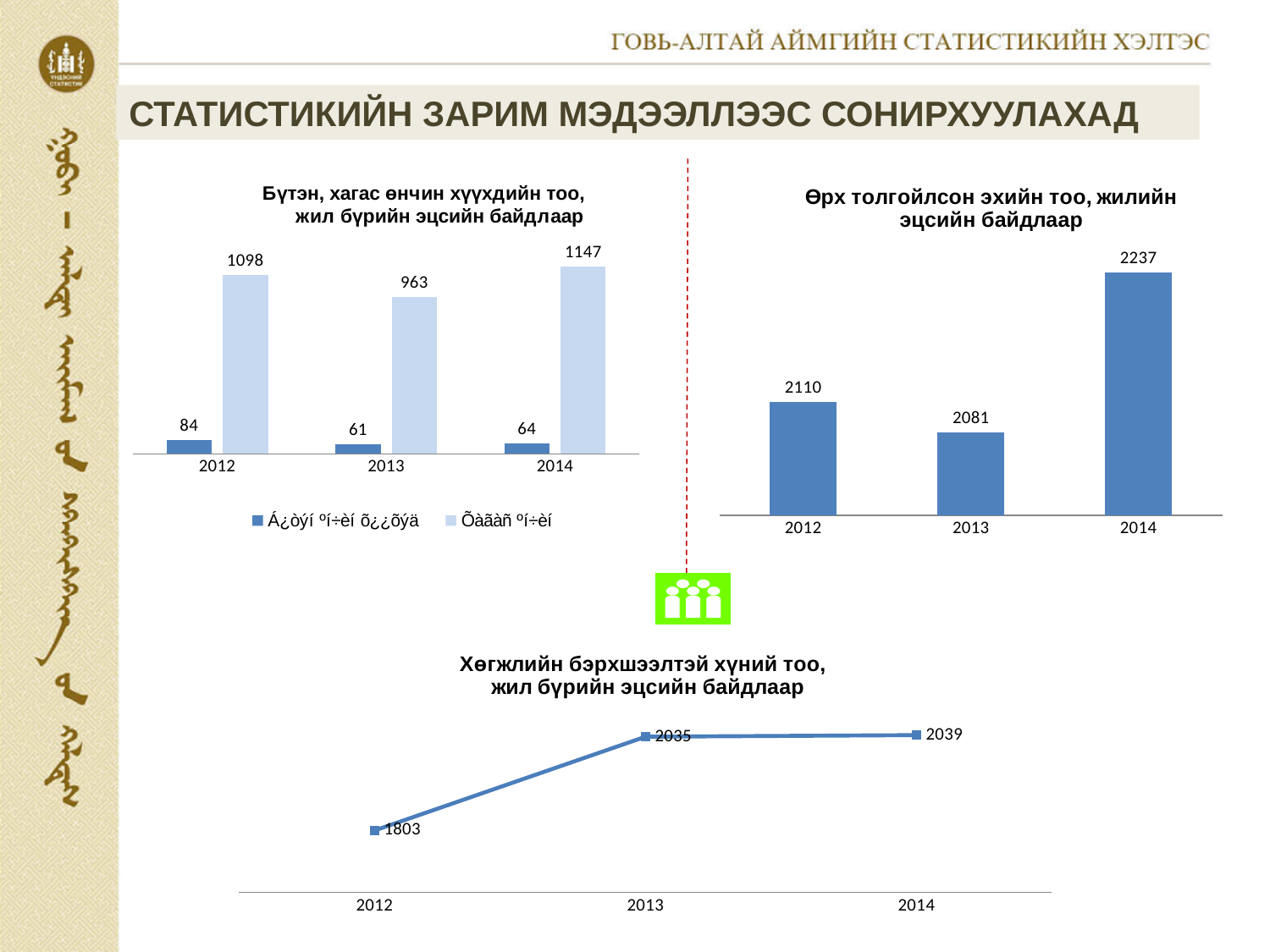
In the chart titled 'Хөгжлийн бэрхшээлтэй хүний тоо, жил бүрийн эцсийн байдлаар', what is the value for 2012? 1803 In the top-left chart titled 'Бүтэн, хагас өнчин хүүхдийн тоо, жил бүрийн эцсийн байдлаар', which year has the lowest light blue bar? 2013 What kind of chart is the one titled 'Хөгжлийн бэрхшээлтэй хүний тоо, жил бүрийн эцсийн байдлаар'? line chart In the top-left chart titled 'Бүтэн, хагас өнчин хүүхдийн тоо, жил бүрийн эцсийн байдлаар', what is the value of the dark blue bar for 2012? 84 In the chart titled 'Өрх толгойлсон эхийн тоо, жилийн эцсийн байдлаар', which year has the lowest value? 2013 How many series does the legend of the top-left chart titled 'Бүтэн, хагас өнчин хүүхдийн тоо, жил бүрийн эцсийн байдлаар' list? 2 In the top-left chart titled 'Бүтэн, хагас өнчин хүүхдийн тоо, жил бүрийн эцсийн байдлаар', what is the value of the light blue bar for 2014? 1147 How many years are shown on the x axis of the chart titled 'Өрх толгойлсон эхийн тоо, жилийн эцсийн байдлаар'? 3 In the chart titled 'Хөгжлийн бэрхшээлтэй хүний тоо, жил бүрийн эцсийн байдлаар', do the values rise or fall from 2012 to 2014? rise In the chart titled 'Өрх толгойлсон эхийн тоо, жилийн эцсийн байдлаар', what is the difference between the 2014 and 2013 values? 156 In the chart titled 'Өрх толгойлсон эхийн тоо, жилийн эцсийн байдлаар', what is the value for 2014? 2237 In the chart titled 'Хөгжлийн бэрхшээлтэй хүний тоо, жил бүрийн эцсийн байдлаар', what is the difference between the 2013 and 2012 values? 232